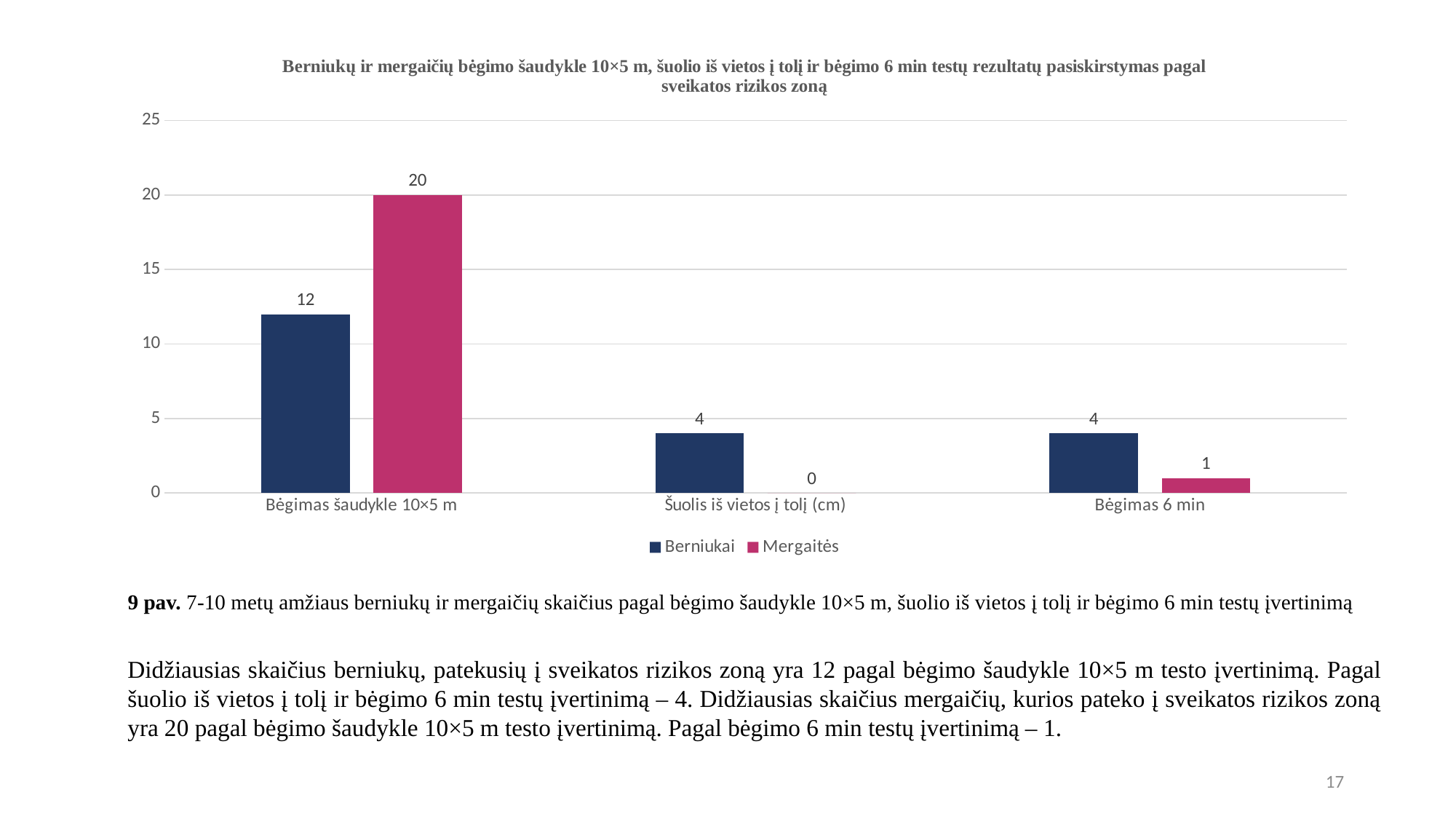
What is the difference between the Mergaitės and Berniukai values in the Bėgimas šaudykle 10×5 m category? 8 How many categories are shown on the x axis? 3 How many series does the legend list? 2 Which category has the lowest value for Mergaitės? Šuolis iš vietos į tolį (cm) What is the value for Berniukai in the Bėgimas 6 min category? 4 Which category has the highest value for Mergaitės? Bėgimas šaudykle 10×5 m In the Bėgimas 6 min category, which series has the larger value, Berniukai or Mergaitės? Berniukai What kind of chart is shown on the slide? Bar chart What is the value for Mergaitės in the Bėgimas šaudykle 10×5 m category? 20 Which series is shown in dark blue in the legend? Berniukai What is the value for Mergaitės in the Šuolis iš vietos į tolį (cm) category? 0 What is the value for Berniukai in the Bėgimas šaudykle 10×5 m category? 12